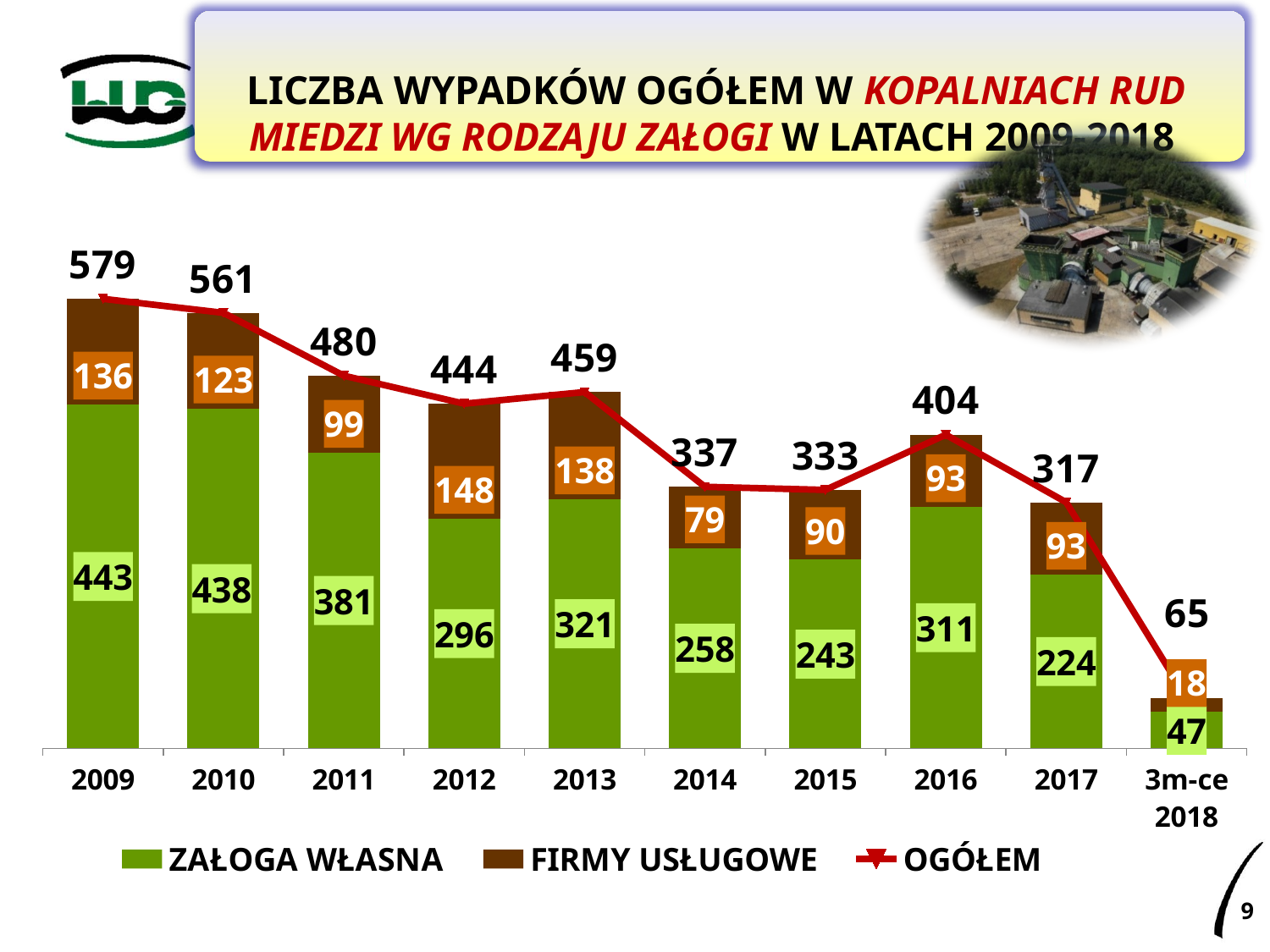
Which is larger, the ZAŁOGA WŁASNA value for 2013 or for 2016? 2013 Which category has the lowest OGÓŁEM value? 3m-ce 2018 What is the OGÓŁEM value for 2016? 404 What is the value for FIRMY USŁUGOWE in 2012? 148 How many categories are shown on the x axis? 10 What is the difference between the OGÓŁEM values for 2009 and 2010? 18 What kind of chart is shown on the slide? Stacked bar chart with a line Which year has the highest OGÓŁEM value? 2009 Does the OGÓŁEM value rise or fall from 2009 to 2012? Fall What is the value for ZAŁOGA WŁASNA in 2009? 443 How many series does the legend list? 3 What is the total of the stacked bar for 2017? 317